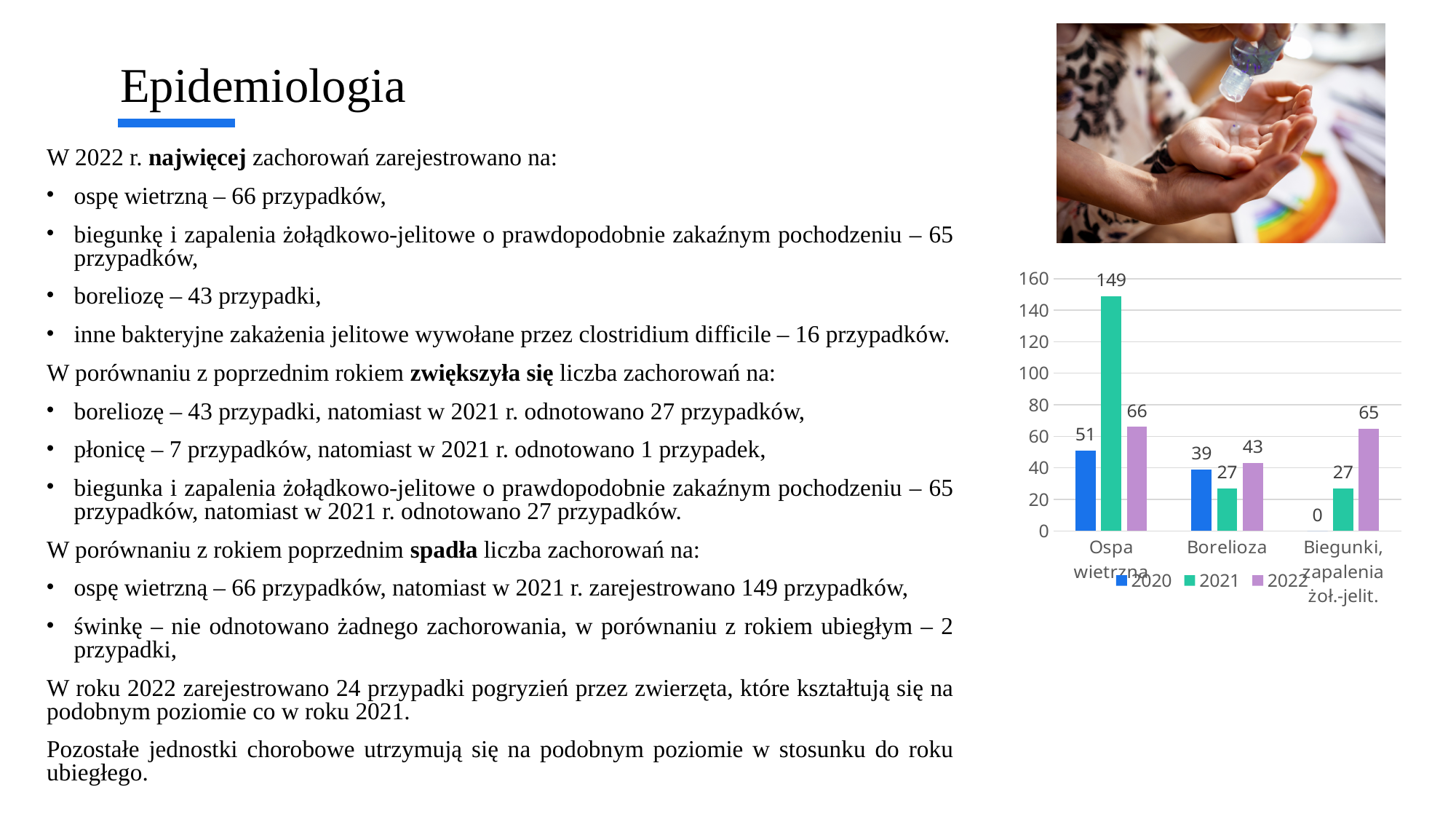
Which category has the lowest value in the 2020 series? Biegunki, zapalenia żoł.-jelit. Which category has the highest value in the 2021 series? Ospa wietrzna What is the value for Ospa wietrzna in 2021? 149 How many series does the chart legend list? 3 Which is larger for Borelioza: the 2020 value or the 2022 value? 2022 What type of chart is shown on the slide? bar chart What is the value for Borelioza in 2022? 43 How many categories are shown on the x axis of the chart? 3 What is the value for Biegunki, zapalenia żoł.-jelit. in 2020? 0 Is the value for Biegunki, zapalenia żoł.-jelit. in 2022 greater or less than 60? greater What is the difference between the 2021 and 2022 values for Ospa wietrzna? 83 Which series is shown in green in the chart? 2021